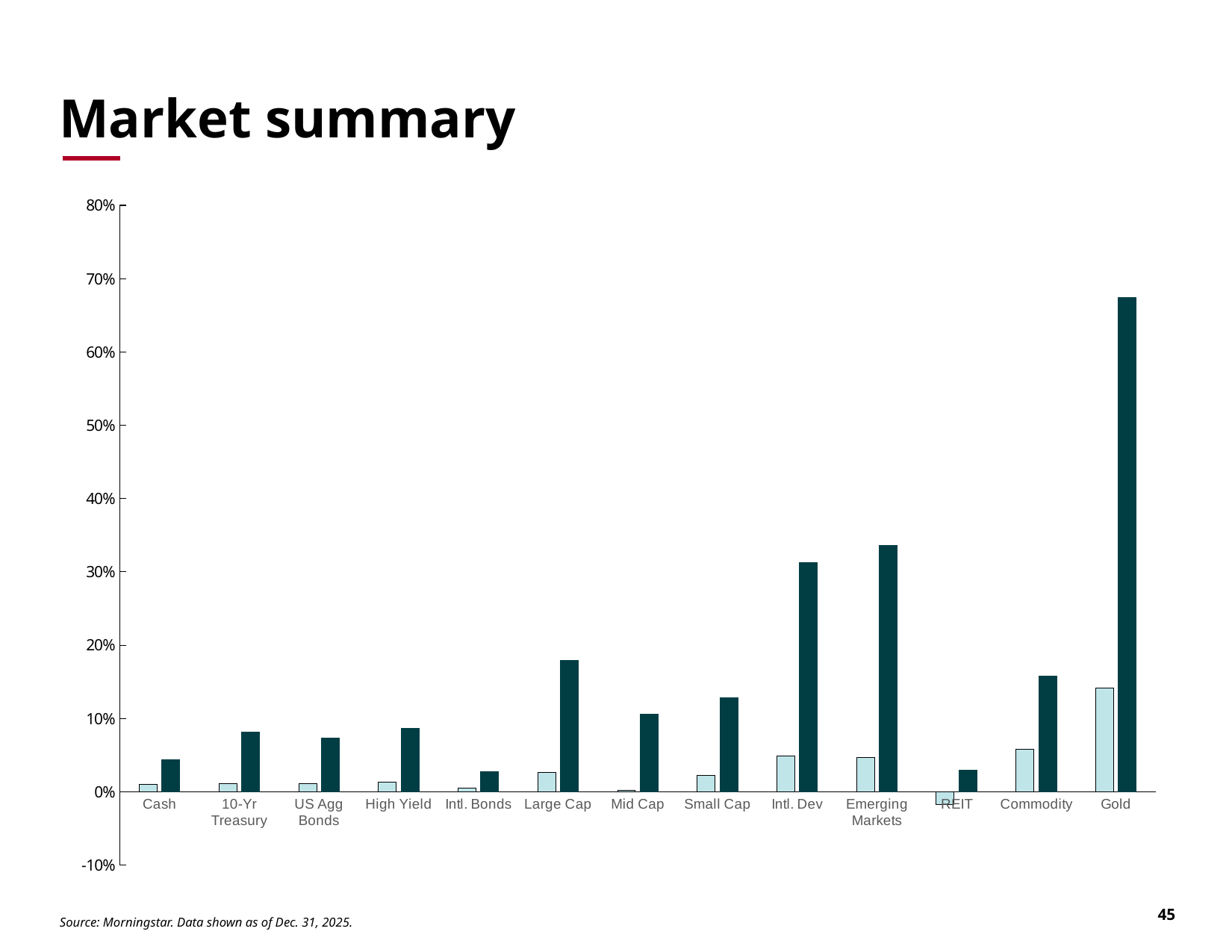
Is the dark teal bar for Emerging Markets greater or less than 30%? greater What kind of chart is shown on the slide? bar chart Which has the larger dark teal bar, Large Cap or Small Cap? Large Cap Is the dark teal bar for Gold greater or less than 60%? greater Which category has the tallest dark teal bar? Gold Which category has the tallest light blue bar? Gold Is the dark teal bar for Large Cap greater or less than 20%? less Which category has the lowest light blue bar? REIT What is the title of the chart slide? Market summary How many asset categories are shown along the x axis? 13 Which category is the only one with a bar below 0%? REIT